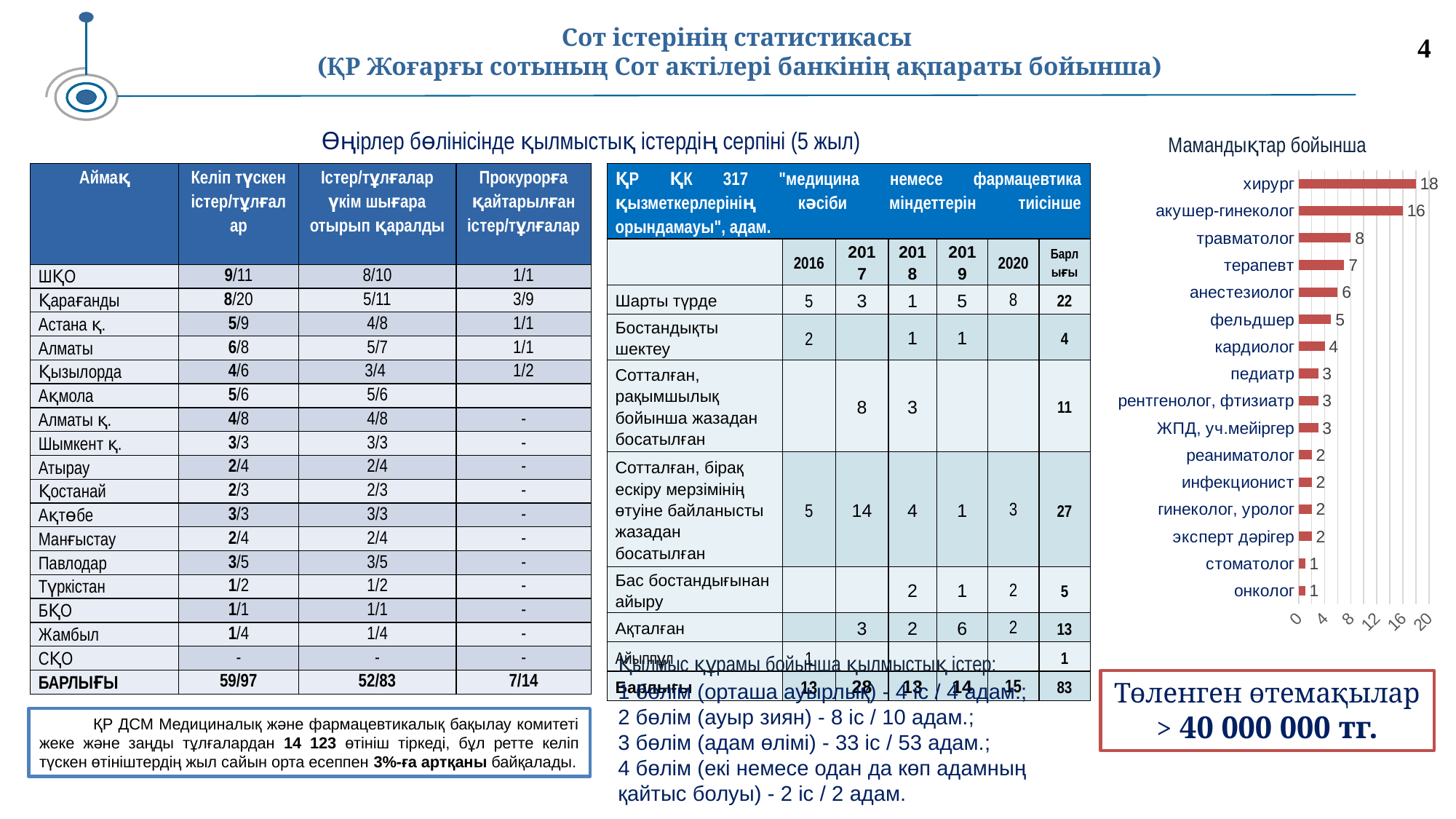
In the chart "Мамандықтар бойынша", which is larger, the value for анестезиолог or the value for фельдшер? анестезиолог In the chart "Мамандықтар бойынша", is the value for акушер-гинеколог greater or less than 12? greater In the chart "Мамандықтар бойынша", what is the difference between the values for хирург and травматолог? 10 What kind of chart is "Мамандықтар бойынша"? bar chart In the chart "Мамандықтар бойынша", which category has the highest value? хирург In the chart "Мамандықтар бойынша", what is the value for хирург? 18 In the chart "Мамандықтар бойынша", what is the value for кардиолог? 4 In the chart "Мамандықтар бойынша", what is the value for акушер-гинеколог? 16 In the chart "Мамандықтар бойынша", what is the value for стоматолог? 1 In the chart "Мамандықтар бойынша", what is the value for терапевт? 7 In the chart "Мамандықтар бойынша", how many categories are plotted? 16 What is the title of the bar chart on the right side of the slide? Мамандықтар бойынша